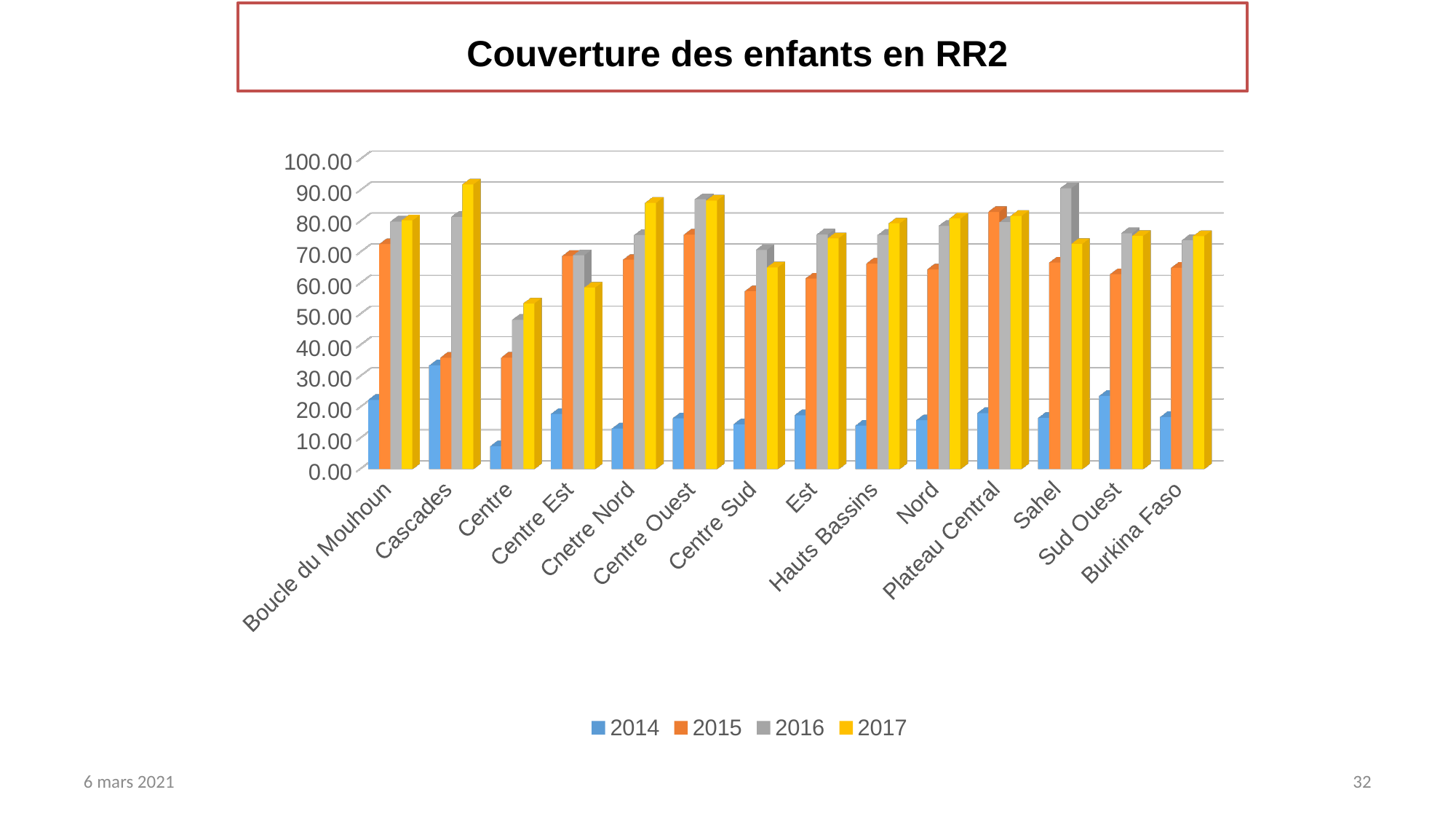
Which region has the highest value for 2017? Cascades For Sahel, which is larger: the 2016 value or the 2017 value? 2016 How many regions (categories) are shown on the x axis? 14 Which region has the lowest value for 2014? Centre For Centre Est, which is larger: the 2015 value or the 2017 value? 2015 Which region has the highest value for 2015? Plateau Central How many series does the legend list? 4 Is the 2014 value for Centre greater or less than 10.00? less Is the 2017 value for Cascades greater or less than 90.00? greater What kind of chart is shown on the slide? bar chart What is the title of the chart? Couverture des enfants en RR2